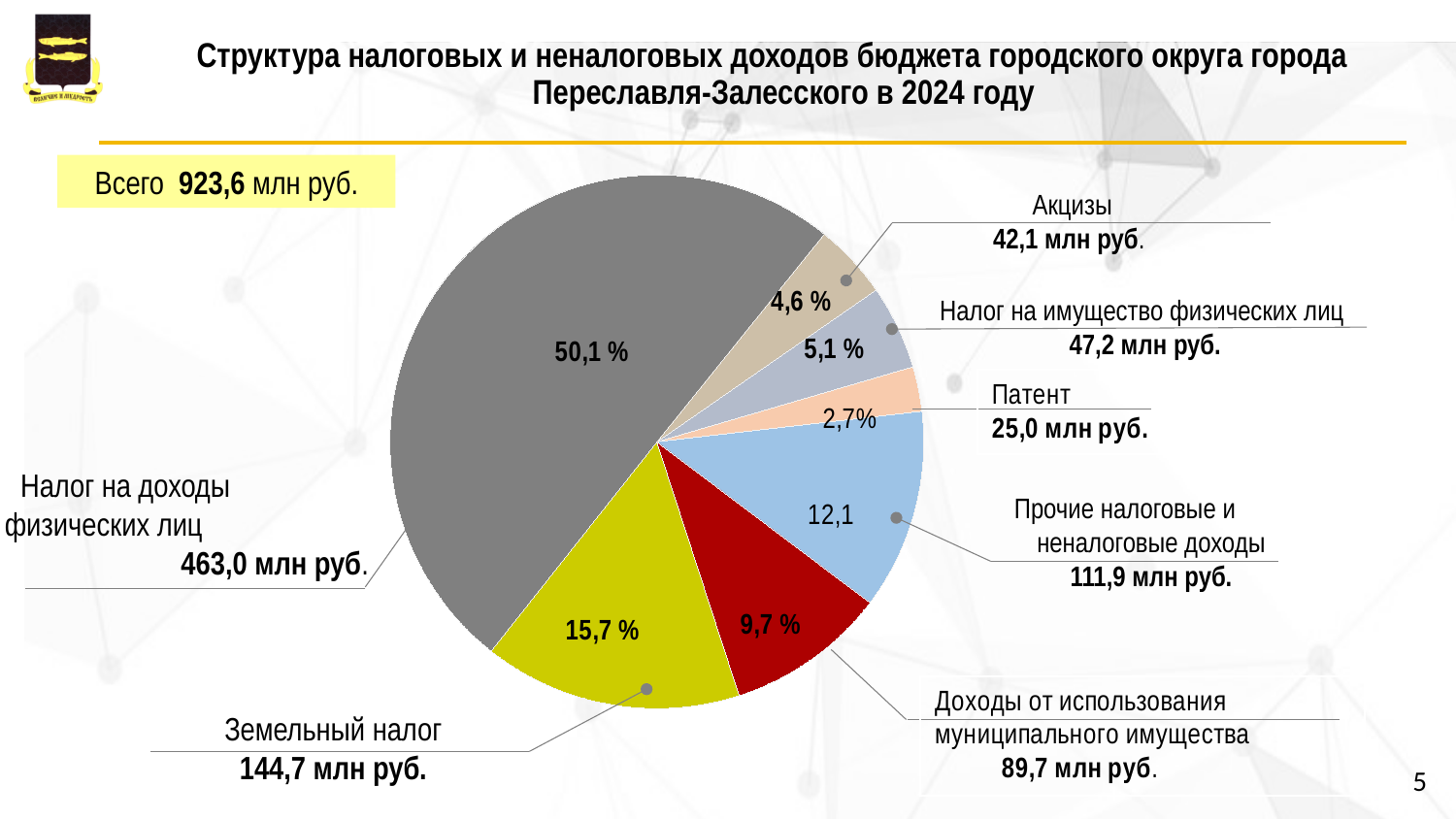
What is the value for Налог на доходы физических лиц? 463,0 млн руб. How many slices does the pie chart have? 7 What is the difference between Налог на имущество физических лиц and Акцизы in млн руб.? 5,1 млн руб. Which category has the smallest slice of the pie? Патент Which is larger: Прочие налоговые и неналоговые доходы or Доходы от использования муниципального имущества? Прочие налоговые и неналоговые доходы What kind of chart is shown on the slide? pie chart What share of the pie does Налог на доходы физических лиц take? 50,1 % What is the value for Патент? 25,0 млн руб. Which category has the largest slice of the pie? Налог на доходы физических лиц What share of the pie does Доходы от использования муниципального имущества take? 9,7 % What is the value for Акцизы? 42,1 млн руб. What is the value for Земельный налог? 144,7 млн руб.